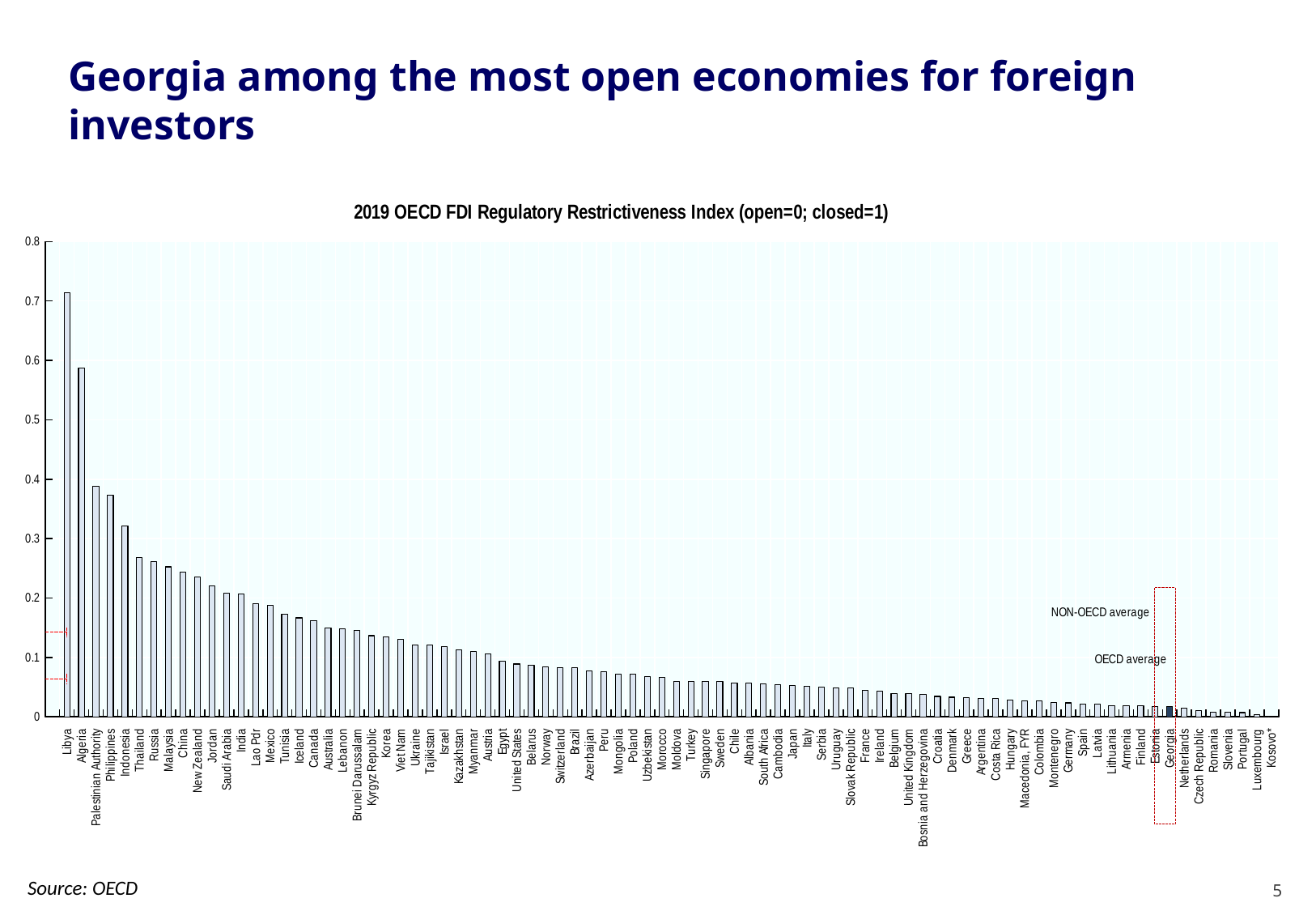
Which has a higher value, Libya or Algeria? Libya Is the value for Georgia greater or less than 0.1? less Do the values rise or fall moving from left to right along the x axis? fall Which country has the highest value on the chart? Libya Is the value for Philippines greater or less than 0.5? less What is the title of the chart? 2019 OECD FDI Regulatory Restrictiveness Index (open=0; closed=1) Is the value for Indonesia greater or less than 0.3? greater What kind of chart is shown on the slide? bar chart Which has a higher value, China or Japan? China Which country has the lowest value on the chart? Kosovo*